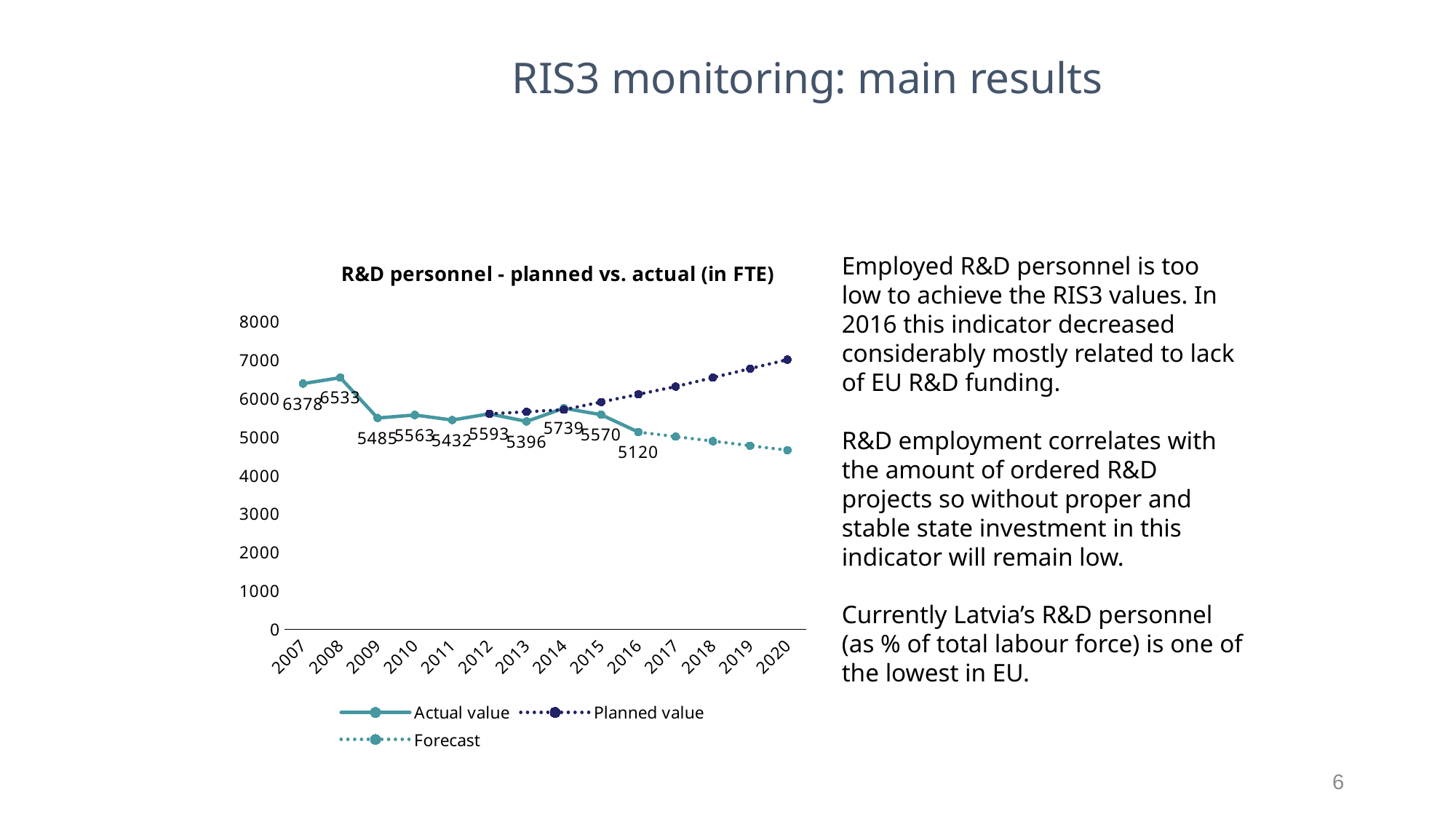
How many series does the legend list? 3 What is the Actual value for 2016? 5120 Is the Forecast value for 2020 greater or less than 5000? less What is the Actual value for 2008? 6533 In which year is the Actual value lowest? 2016 What is the difference between the Actual values for 2014 and 2016? 619 In which year is the Actual value highest? 2008 Is the Planned value for 2020 greater or less than 6000? greater What kind of chart is shown on the slide? line chart What is the difference between the Actual values for 2008 and 2007? 155 How many years are shown on the x axis? 14 Which year has the larger Actual value, 2012 or 2013? 2012